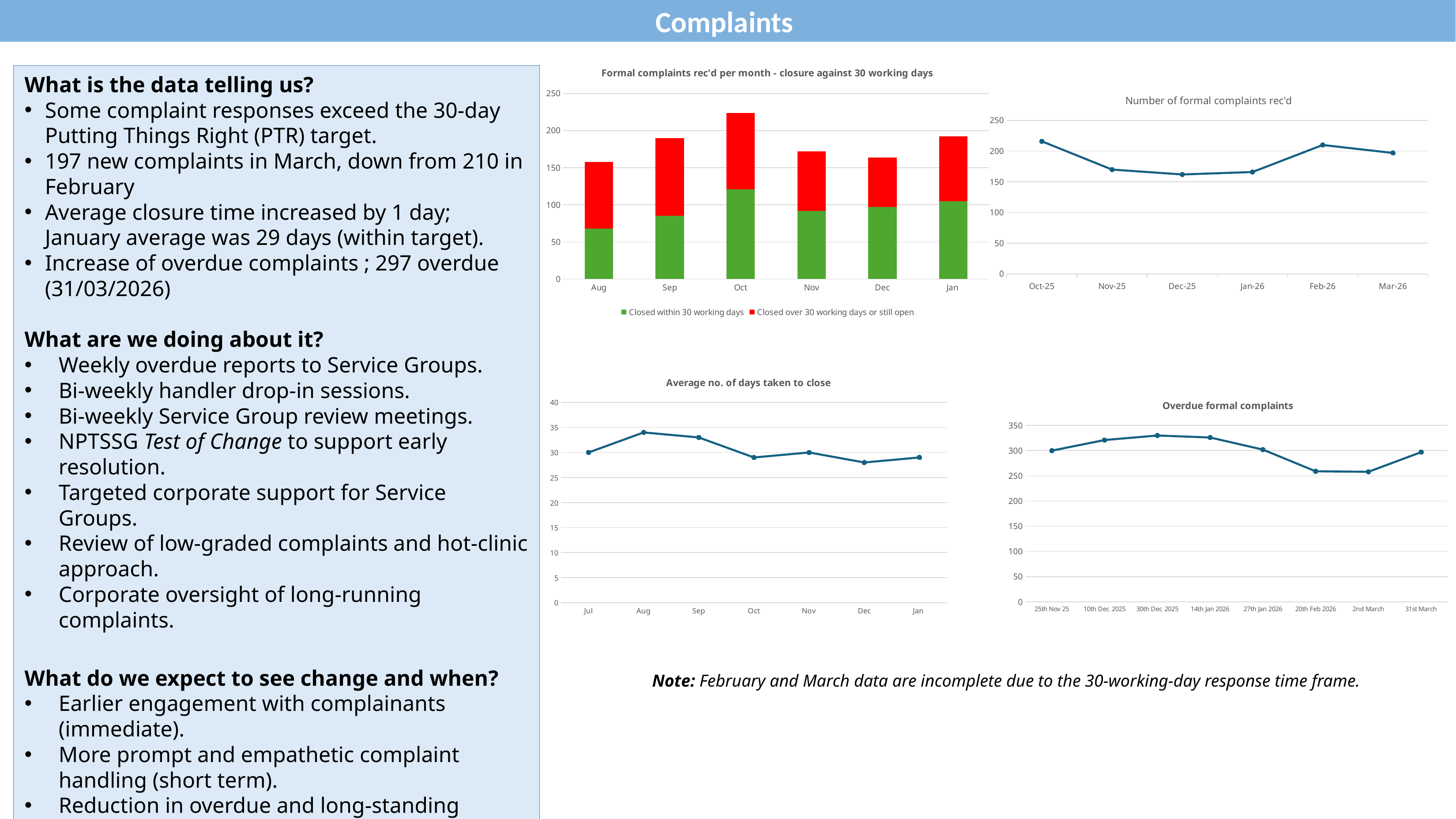
How many series does the legend of the 'Formal complaints rec'd per month - closure against 30 working days' chart list? 2 In the 'Average no. of days taken to close' chart, which month has the lowest value? Dec What kind of chart is the 'Formal complaints rec'd per month - closure against 30 working days' chart? stacked bar chart What kind of chart is the 'Overdue formal complaints' chart? line chart In the 'Formal complaints rec'd per month - closure against 30 working days' chart, which month has the tallest total bar? Oct How many months are shown on the x axis of the 'Number of formal complaints rec'd' chart? 6 In the 'Average no. of days taken to close' chart, which month has the highest value? Aug In the 'Number of formal complaints rec'd' chart, is the value for Dec-25 greater or less than 200? less In the 'Formal complaints rec'd per month - closure against 30 working days' chart, is the total bar for Oct greater or less than 200? greater In the 'Average no. of days taken to close' chart, is the value for Aug greater or less than 30? greater In the 'Formal complaints rec'd per month - closure against 30 working days' chart, which month has the shortest total bar? Aug